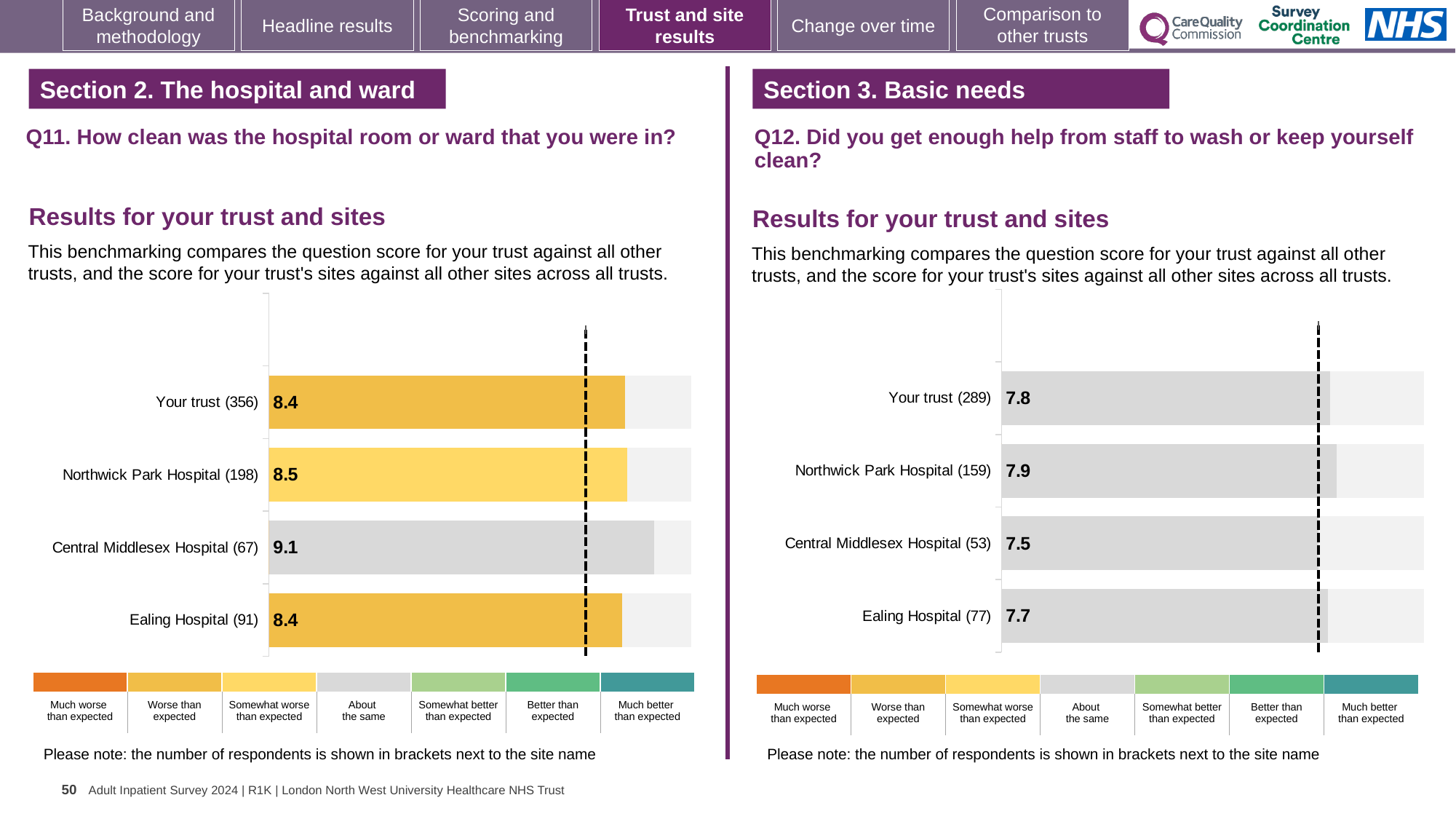
In the Q11 chart on the left, which site or trust has the highest score? Central Middlesex Hospital In the Q11 chart on the left, how many respondents are shown in brackets for Your trust? 356 In the Q11 chart on the left, what is the score for Northwick Park Hospital? 8.5 In the Q12 chart on the right, which has the larger score, Northwick Park Hospital or Ealing Hospital? Northwick Park Hospital How many bars are plotted in the Q11 chart on the left? 4 What kind of chart is used for the Q12 results on the right? Bar chart In the Q11 chart on the left, what is the difference between the scores for Central Middlesex Hospital and Ealing Hospital? 0.7 In the Q12 chart on the right, which site or trust has the lowest score? Central Middlesex Hospital In the Q12 chart on the right, what is the difference between the scores for Northwick Park Hospital and Central Middlesex Hospital? 0.4 In the Q12 chart on the right, what is the score for Your trust? 7.8 In the Q11 chart on the left, what is the score for Central Middlesex Hospital? 9.1 In the Q12 chart on the right, what is the score for Ealing Hospital? 7.7